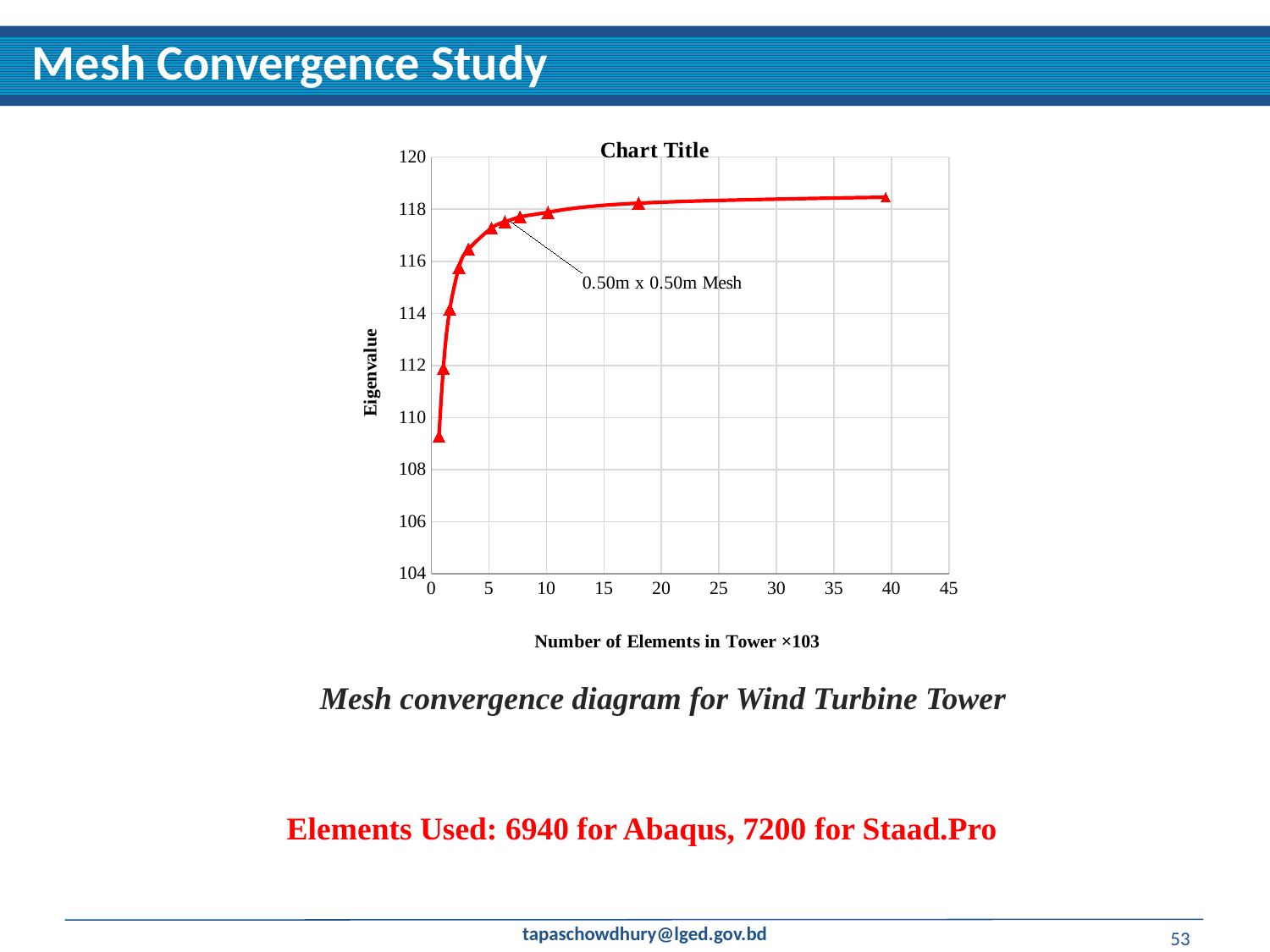
Is the eigenvalue for the first (leftmost) data point greater or less than 110? less What is the label on the vertical axis of the chart? Eigenvalue Is the eigenvalue at the leftmost data point larger or smaller than the eigenvalue at the rightmost data point? Smaller Is the eigenvalue for the data point near 1 on the x axis greater or less than 114? less Does the eigenvalue rise or fall as the number of elements in the tower increases? Rises Is the eigenvalue for the last (rightmost) data point, near 40 on the x axis, greater or less than 118? greater What mesh size does the annotation on the chart point to? 0.50m x 0.50m Mesh Which data point has the highest eigenvalue: the one near 40 on the x axis or the one near 5? The one near 40 What kind of chart is shown on the slide? Line chart